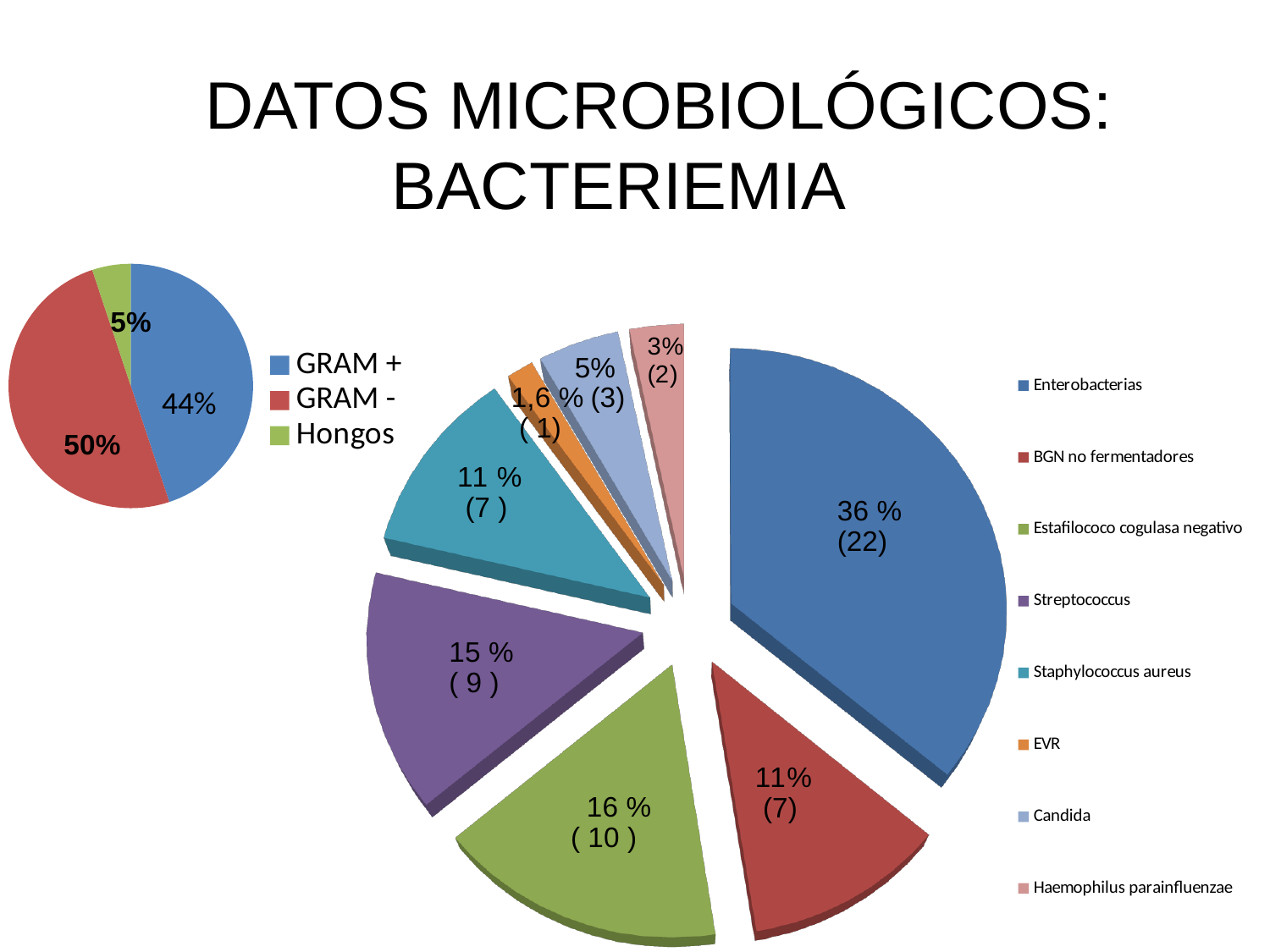
In the small pie chart on the left, what percentage is shown for GRAM -? 50% In the large pie chart on the right, which category has the smallest share? EVR In the small pie chart on the left, what percentage is shown for Hongos? 5% In the large pie chart on the right, how many categories does the legend list? 8 What kind of chart is the large chart on the right? Pie chart In the small pie chart on the left, how many categories does the legend list? 3 In the small pie chart on the left, which category has the largest share? GRAM - In the large pie chart on the right, which category has the largest share? Enterobacterias In the large pie chart on the right, what is the difference in count between Estafilococo cogulasa negativo and Candida? 7 In the large pie chart on the right, what percentage and count are shown for Streptococcus? 15 % (9) In the large pie chart on the right, what percentage and count are shown for Enterobacterias? 36 % (22) In the large pie chart on the right, what percentage and count are shown for EVR? 1,6 % (1)